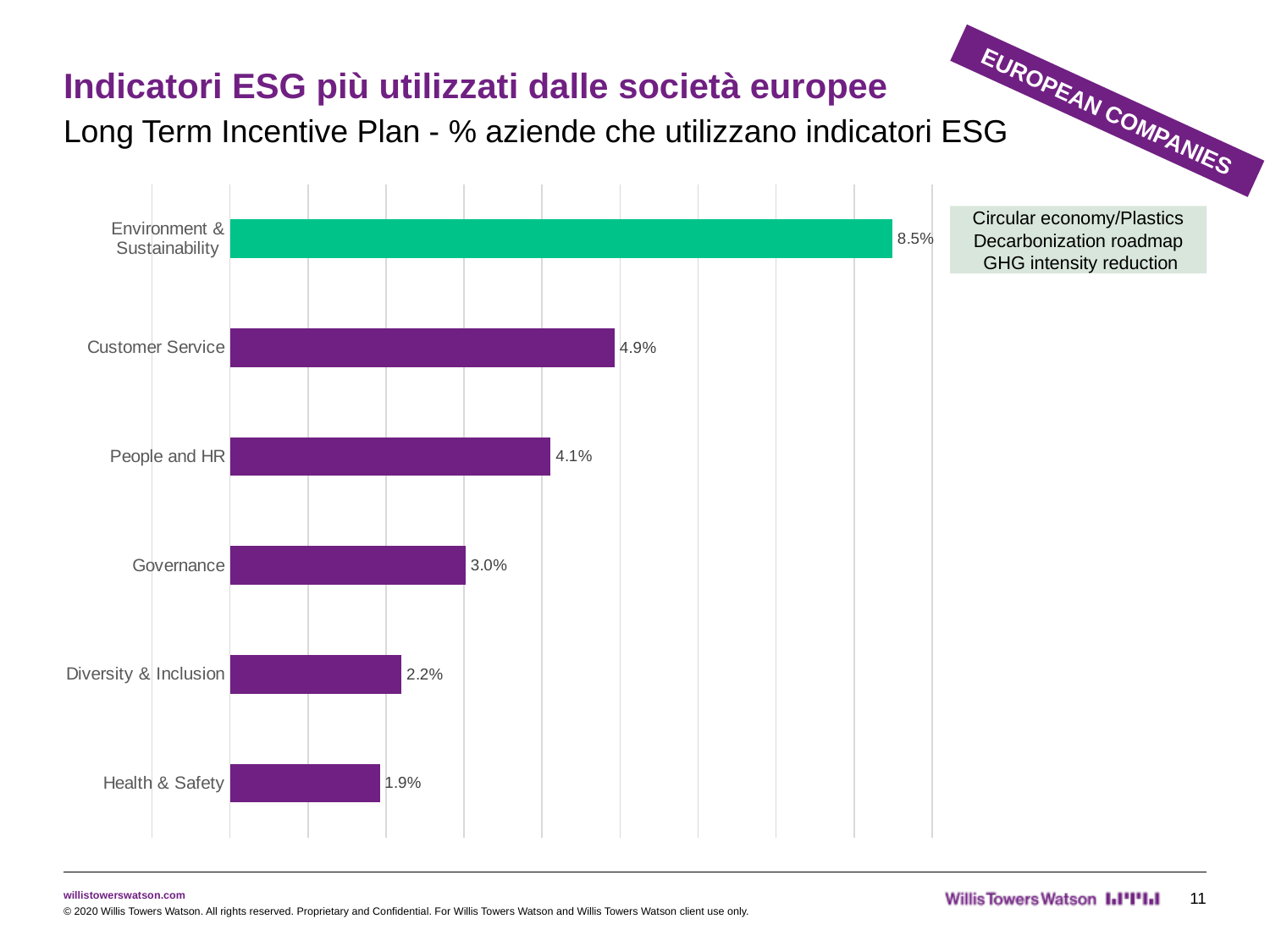
What is the value shown for Customer Service? 4.9% What is the value shown for Governance? 3.0% Which ESG indicator category has the lowest percentage? Health & Safety Which ESG indicator category has the highest percentage? Environment & Sustainability Which is larger, the value for People and HR or the value for Governance? People and HR How many ESG indicator categories are shown in the chart? 6 Which bar is shown in a different colour (green) from the others? Environment & Sustainability What percentage of companies use Environment & Sustainability indicators in their Long Term Incentive Plan? 8.5% What is the difference between the values for Environment & Sustainability and Customer Service? 3.6% What is the difference between the values for People and HR and Diversity & Inclusion? 1.9% What is the value shown for Health & Safety? 1.9% What type of chart is shown on the slide? Bar chart